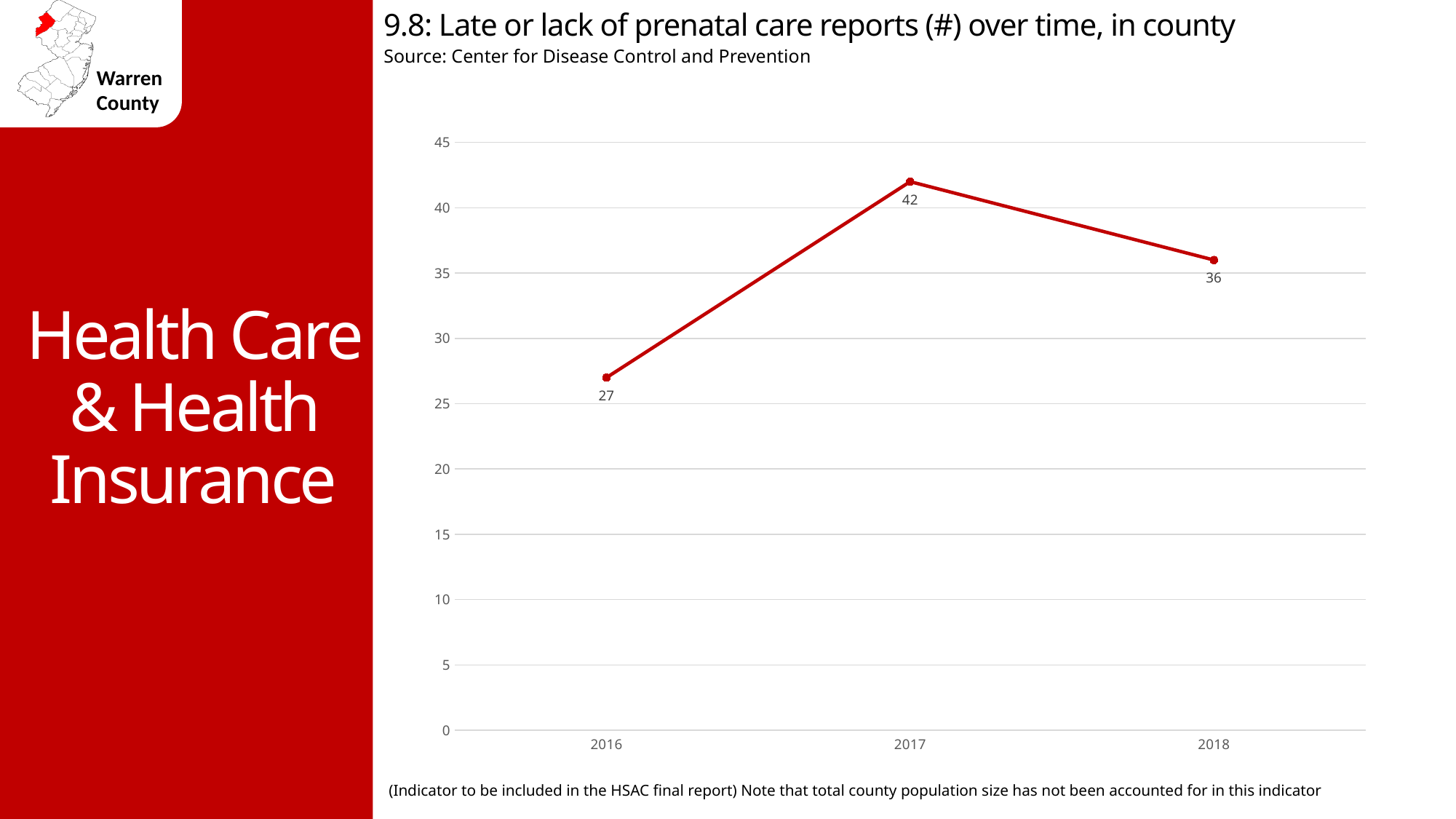
What is the source of the data shown in the chart? Center for Disease Control and Prevention What kind of chart is shown on the slide? line chart What is the number of late or lack of prenatal care reports in 2018? 36 Which year has more late or lack of prenatal care reports, 2016 or 2018? 2018 What is the difference between the number of reports in 2017 and 2016? 15 Is the value for 2018 greater or less than 40? less What is the number of late or lack of prenatal care reports in 2017? 42 What is the difference between the number of reports in 2017 and 2018? 6 How many years are plotted on the chart? 3 Which year has the highest number of late or lack of prenatal care reports? 2017 What is the number of late or lack of prenatal care reports in 2016? 27 Which year has the lowest number of late or lack of prenatal care reports? 2016